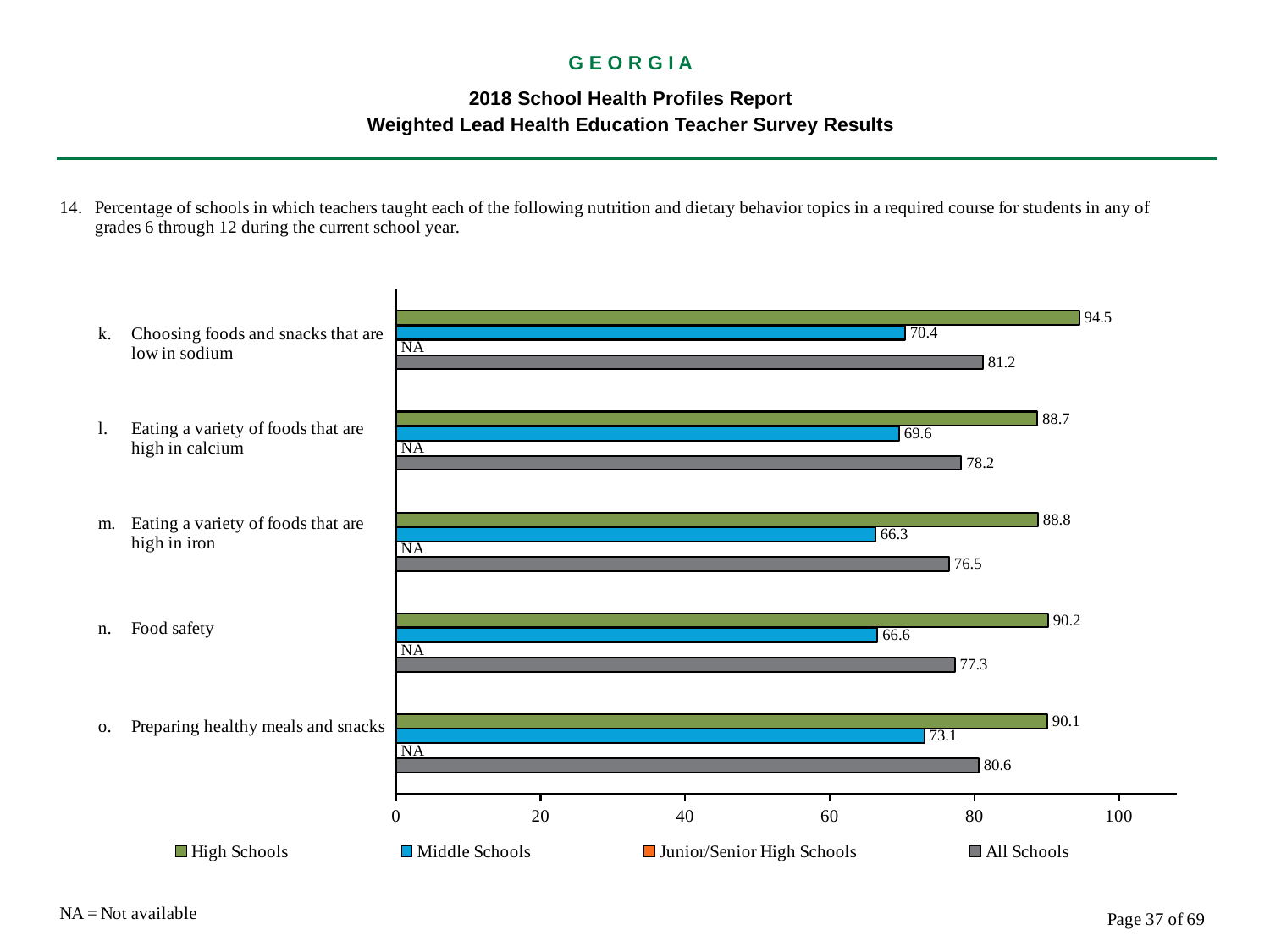
What kind of chart is shown on the slide? bar chart Which topic has the lowest Middle Schools value? Eating a variety of foods that are high in iron How many series does the legend list? 4 Which topic has the highest High Schools value? Choosing foods and snacks that are low in sodium What is the difference between the High Schools and Middle Schools values for "Eating a variety of foods that are high in calcium"? 19.1 What is the High Schools value for "Choosing foods and snacks that are low in sodium"? 94.5 What is shown for Junior/Senior High Schools for "Eating a variety of foods that are high in iron"? NA What is the Middle Schools value for "Food safety"? 66.6 What is the All Schools value for "Preparing healthy meals and snacks"? 80.6 Is the Middle Schools value for "Preparing healthy meals and snacks" greater or less than 80? less Which is larger: the All Schools value for "Food safety" or the All Schools value for "Eating a variety of foods that are high in iron"? Food safety How many topics (categories) are shown on the chart? 5